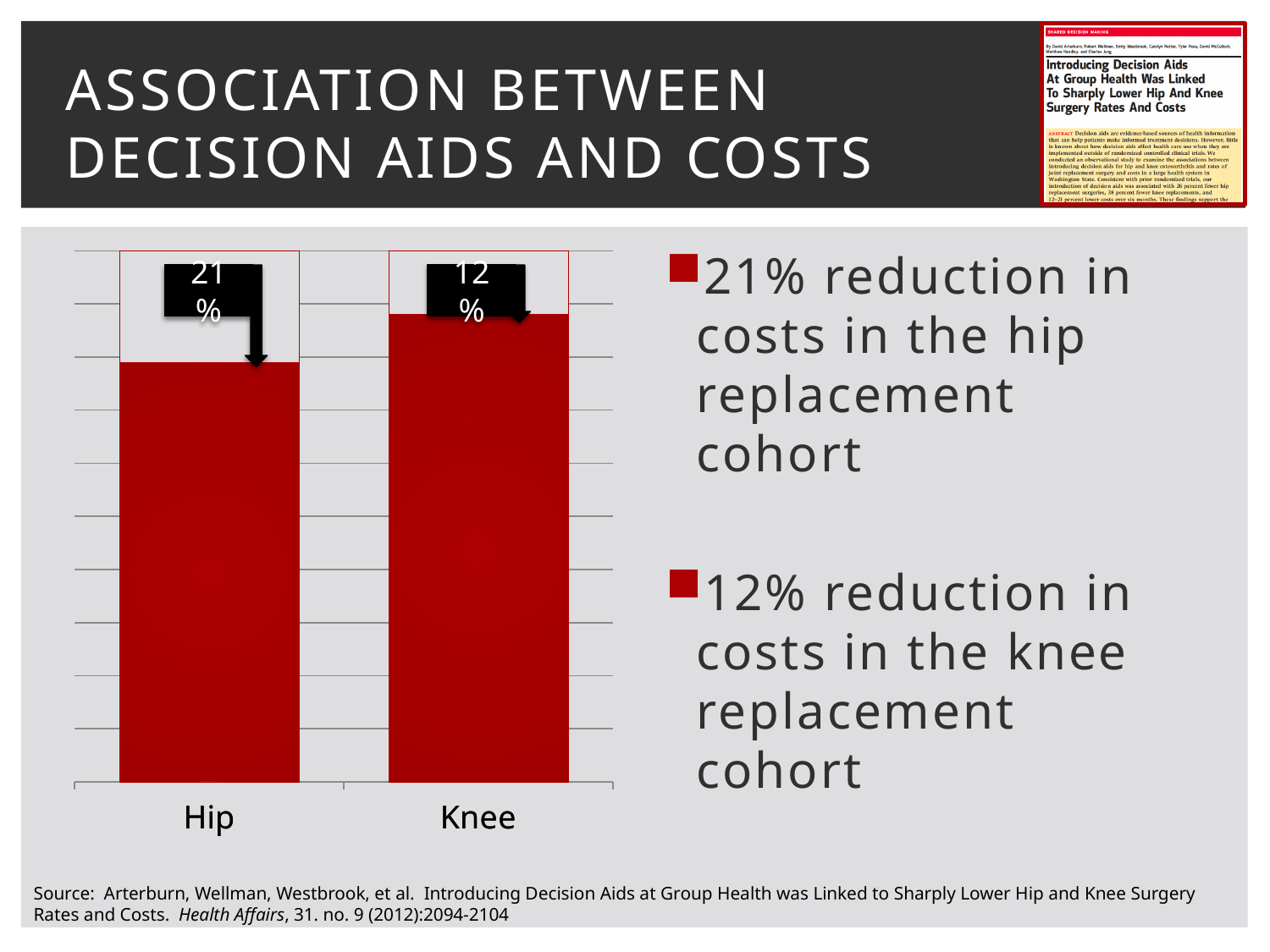
Which bar is taller, Hip or Knee? Knee What colour are the bars in the chart? Red What are the two category labels on the x axis? Hip and Knee Which category shows the larger labelled cost reduction, Hip or Knee? Hip How many categories are shown on the x axis of the chart? 2 What percentage reduction in costs is labelled for the Hip bar? 21% By how many percentage points does the Hip cost reduction exceed the Knee cost reduction? 9 percentage points What percentage reduction in costs is labelled for the Knee bar? 12% Which category shows the smaller labelled cost reduction? Knee What kind of chart is shown on the slide? Bar chart